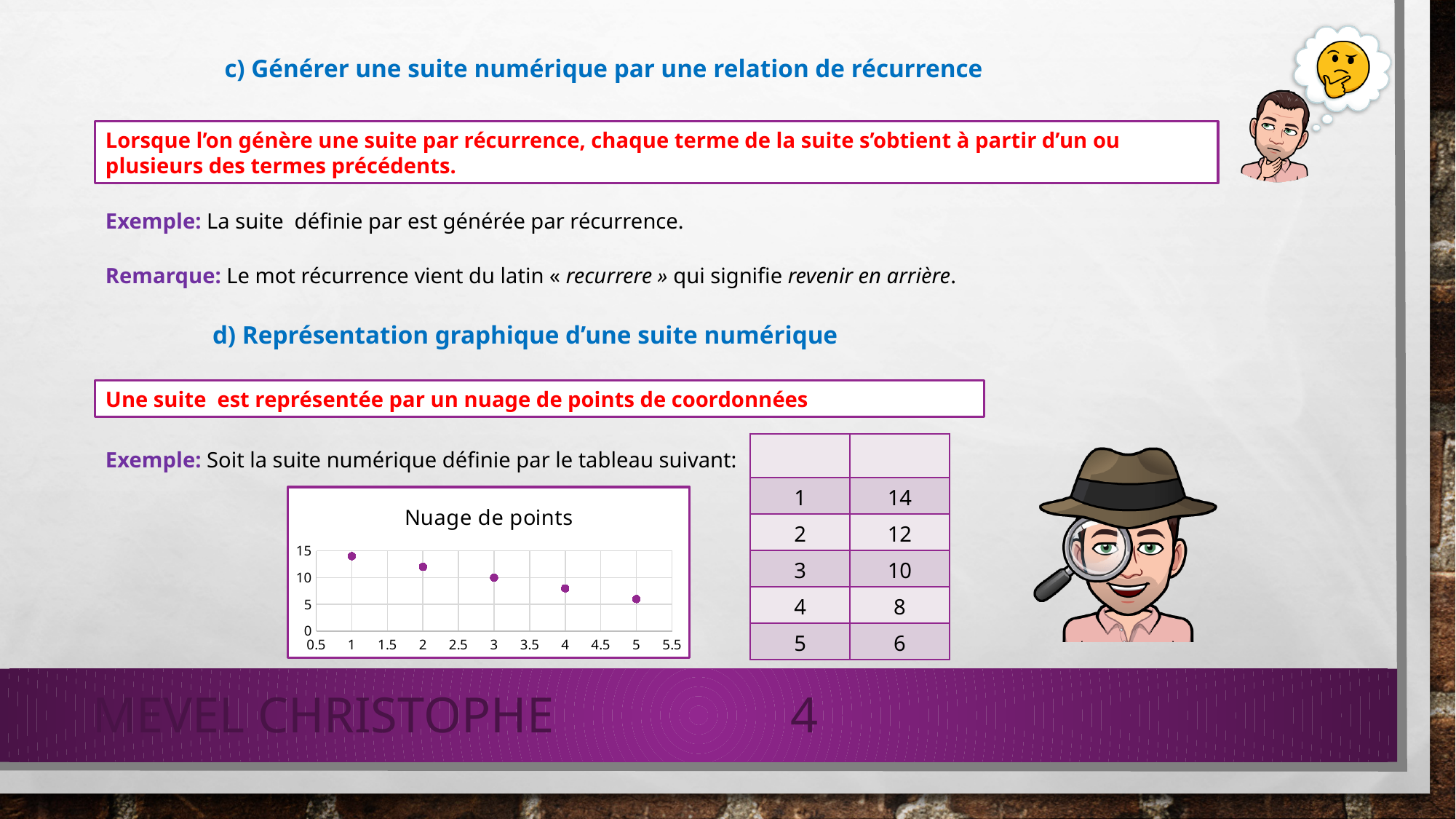
Which is larger, the value at x = 2 or the value at x = 4? x = 2 Do the plotted values rise or fall as x increases? fall What is the value plotted at x = 5 in the chart? 6 At which x value is the plotted point lowest? 5 Is the value at x = 4 greater or less than 10? less At which x value is the plotted point highest? 1 What is the title of the chart on the slide? Nuage de points What is the value plotted at x = 3 in the chart? 10 What kind of chart is shown on the slide? scatter chart What is the value plotted at x = 1 in the chart? 14 How many points are plotted in the chart? 5 What is the difference between the values at x = 1 and x = 5? 8